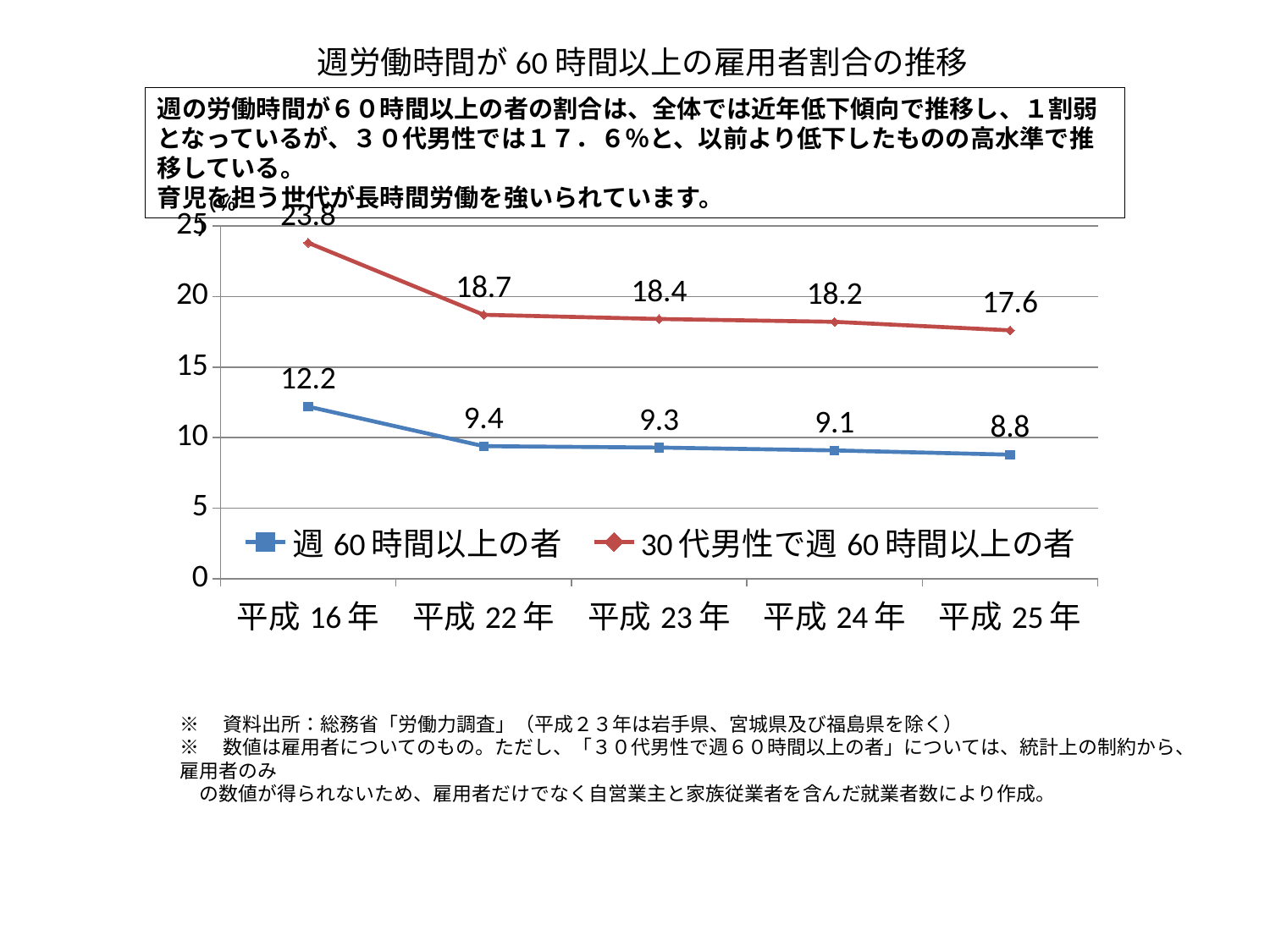
Which series has the larger value in 平成22年, 週60時間以上の者 or 30代男性で週60時間以上の者? 30代男性で週60時間以上の者 What is the value for 週60時間以上の者 in 平成23年? 9.3 What kind of chart is shown on the slide? line chart How many years are shown on the x axis? 5 What is the value for 30代男性で週60時間以上の者 in 平成24年? 18.2 What is the value for 30代男性で週60時間以上の者 in 平成16年? 23.8 What is the difference between the two series in 平成25年? 8.8 In which year is the value for 30代男性で週60時間以上の者 highest? 平成16年 In which year is the value for 週60時間以上の者 lowest? 平成25年 How many series does the legend list? 2 What is the difference between the 平成16年 and 平成22年 values for 週60時間以上の者? 2.8 What is the value for 週60時間以上の者 in 平成25年? 8.8